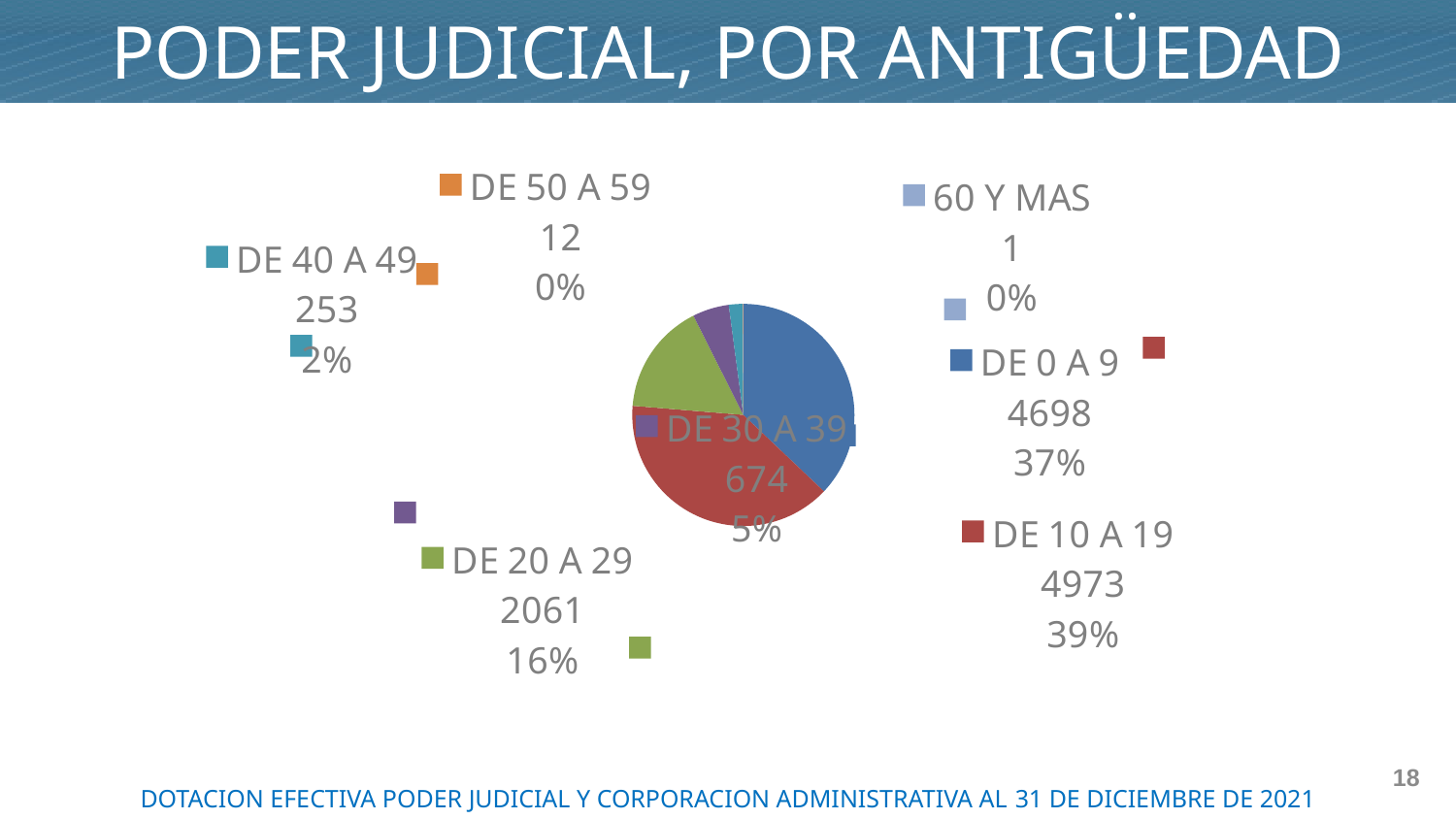
What is the value for 60 Y MAS? 1 What is the value for DE 20 A 29? 2061 Which category has the largest slice of the pie? DE 10 A 19 What share of the pie does DE 30 A 39 represent? 5% How many categories does the pie chart show? 7 What share of the pie does DE 10 A 19 represent? 39% What is the title of the chart slide? PODER JUDICIAL, POR ANTIGÜEDAD Which category has the smallest value? 60 Y MAS What is the value for DE 0 A 9? 4698 What type of chart is shown on the slide? pie chart What is the difference between the values for DE 10 A 19 and DE 0 A 9? 275 What is the value for DE 40 A 49? 253